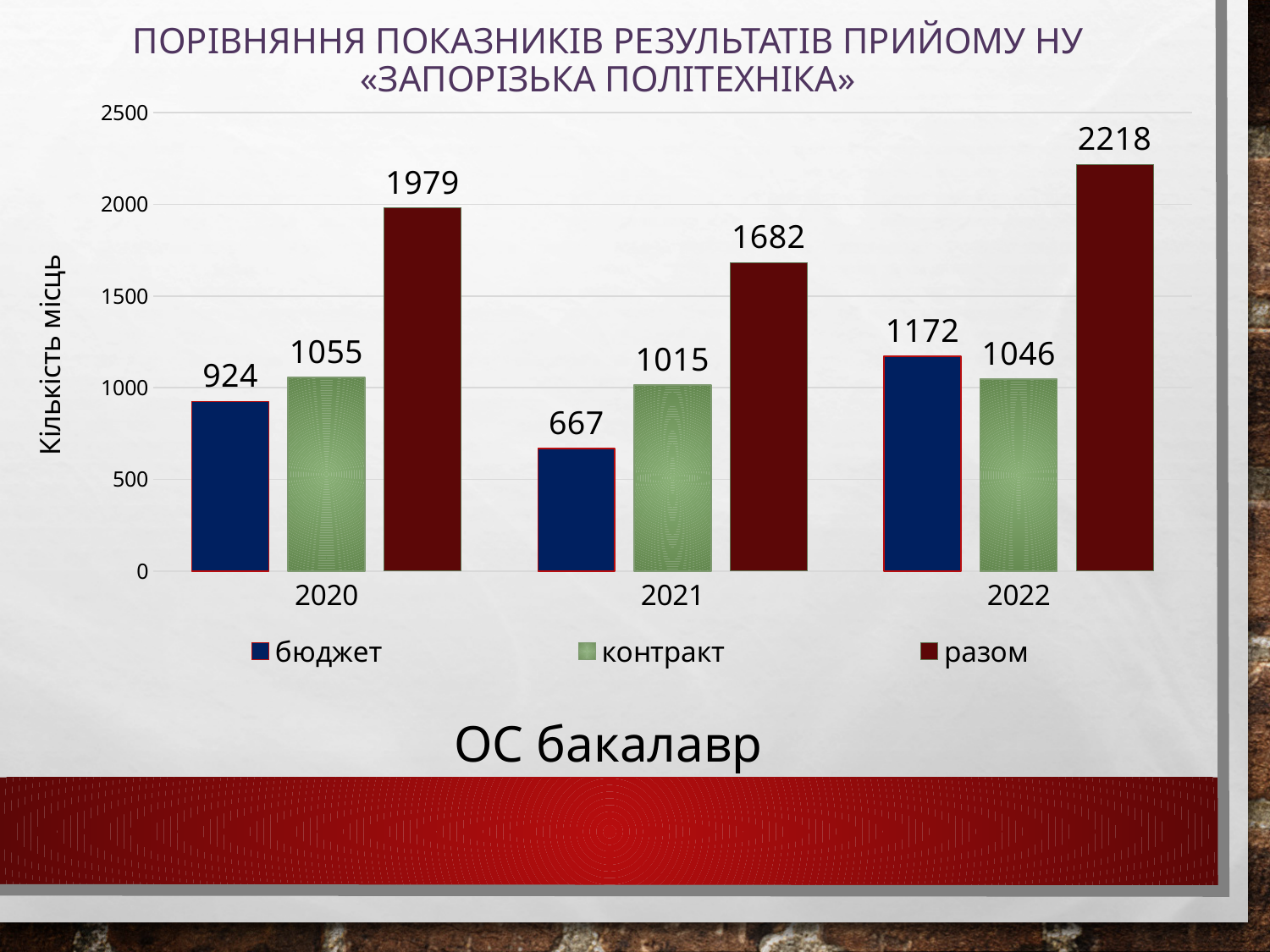
In which year is the разом value highest? 2022 What kind of chart is shown on the slide? bar chart What is the difference between the разом values for 2022 and 2021? 536 How many years are shown on the x axis? 3 What is the value for бюджет in 2020? 924 How many series does the legend list? 3 Is the value for разом in 2021 greater or less than 1500? greater Which is larger in 2022, бюджет or контракт? бюджет In which year is the бюджет value lowest? 2021 What is the label of the y axis? Кількість місць What is the value for контракт in 2021? 1015 What is the value for разом in 2022? 2218